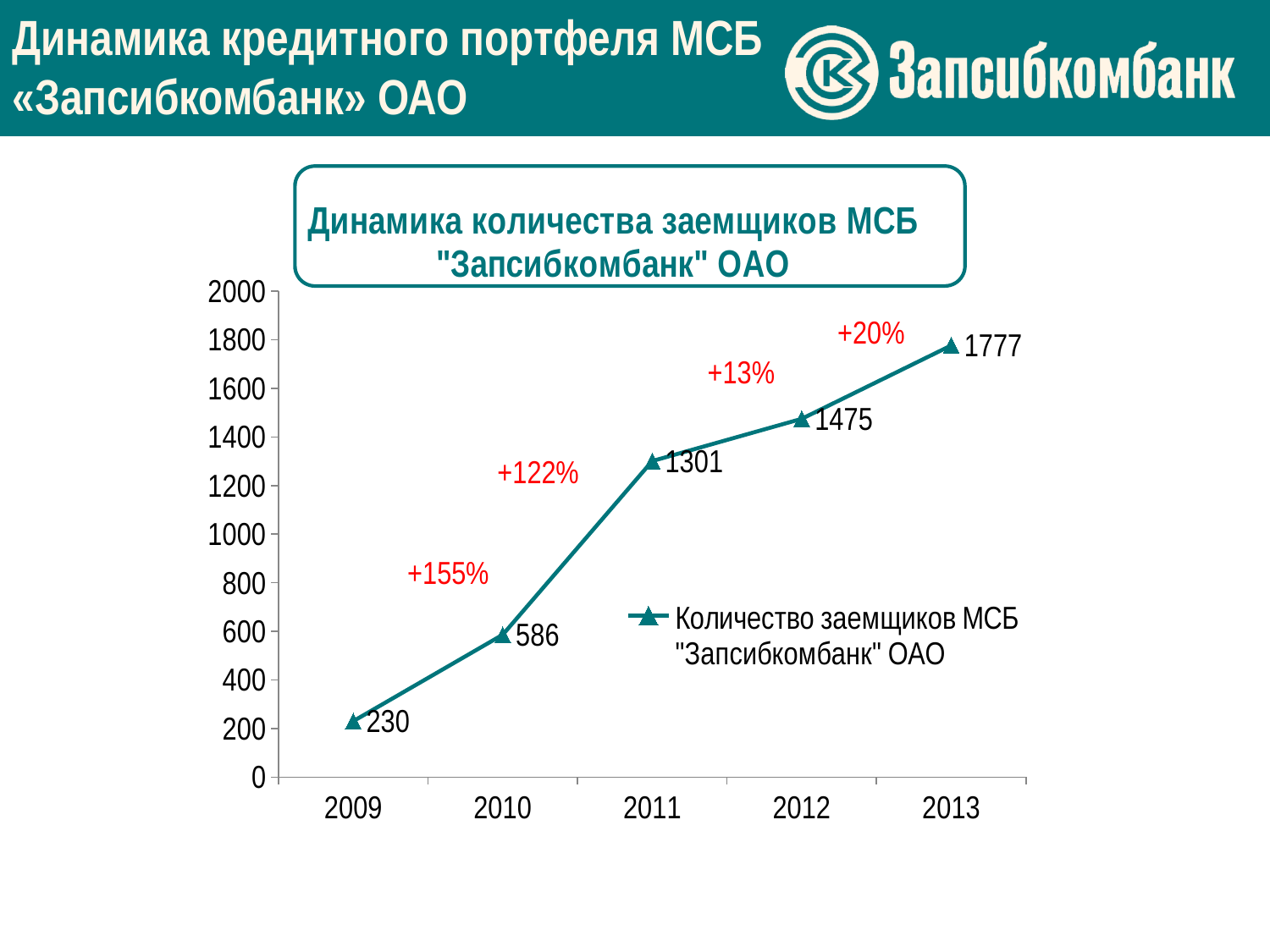
What kind of chart is shown? line chart What is the value for 2009? 230 What is the value for 2011? 1301 What is the difference between the values for 2013 and 2012? 302 What is the value for 2013? 1777 Which year has the lowest value? 2009 What is the difference between the values for 2010 and 2009? 356 How many series does the legend list? 1 Which is larger, the value for 2011 or the value for 2010? 2011 How many years are plotted on the chart? 5 Do the values rise or fall from 2009 to 2013? rise Which year has the highest value? 2013